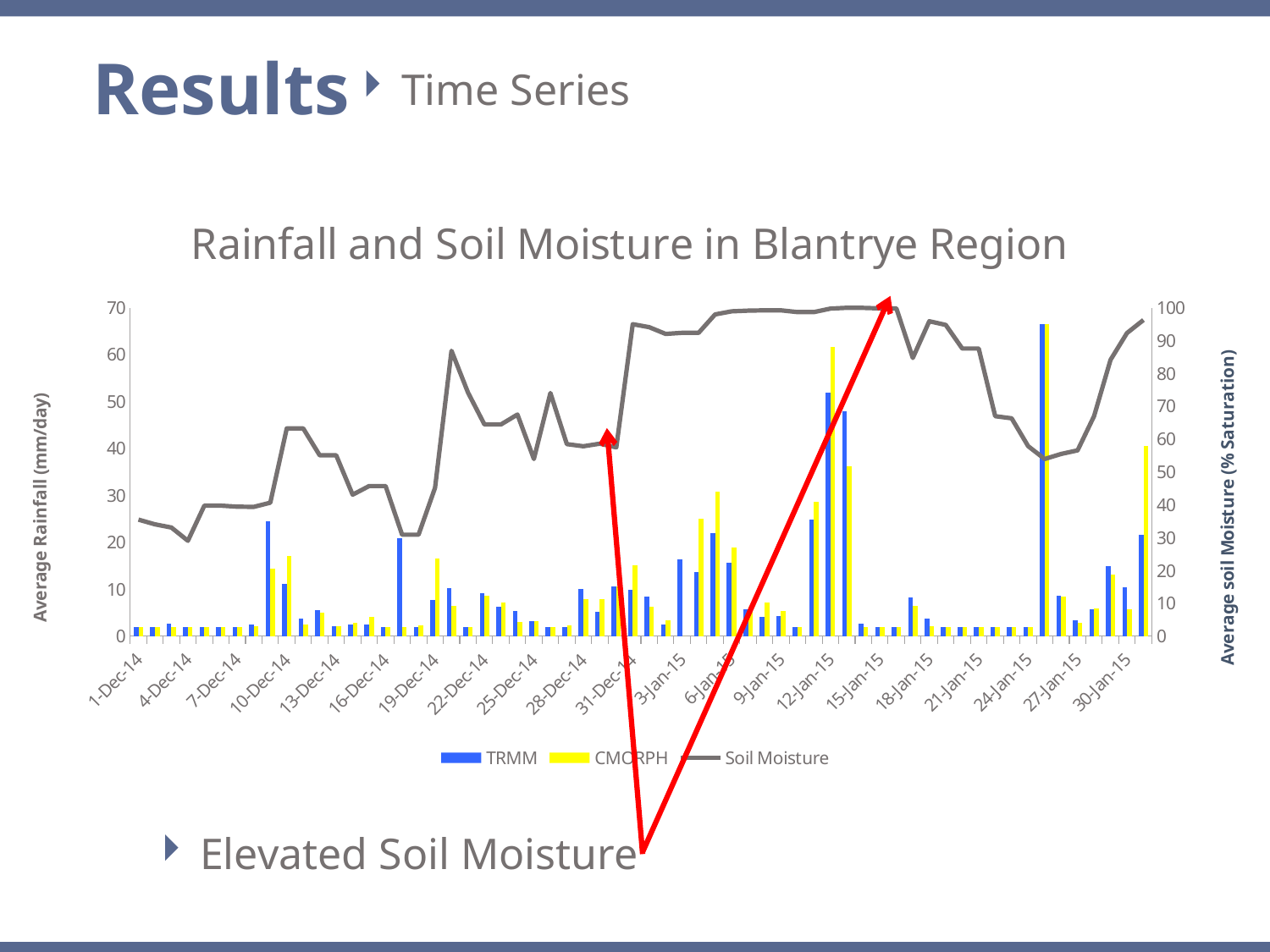
Does the Soil Moisture line rise or fall overall from 1-Dec-14 to 15-Jan-15? rise Is the TRMM value on 24-Jan-15 greater or less than 60 mm/day? less How many series does the chart legend list? 3 How many date labels are shown on the x axis? 21 What is the title of the chart? Rainfall and Soil Moisture in Blantrye Region What is the label of the left vertical axis? Average Rainfall (mm/day) On which date is the TRMM bar highest? 25-Jan-15 Which is larger, the TRMM value on 24-Jan-15 or the TRMM value on 12-Jan-15? 12-Jan-15 Is the Soil Moisture value on 15-Jan-15 greater or less than 90% saturation? greater Is the CMORPH value on 12-Jan-15 greater or less than 50 mm/day? greater What kind of chart is shown on the slide? A combined bar and line chart